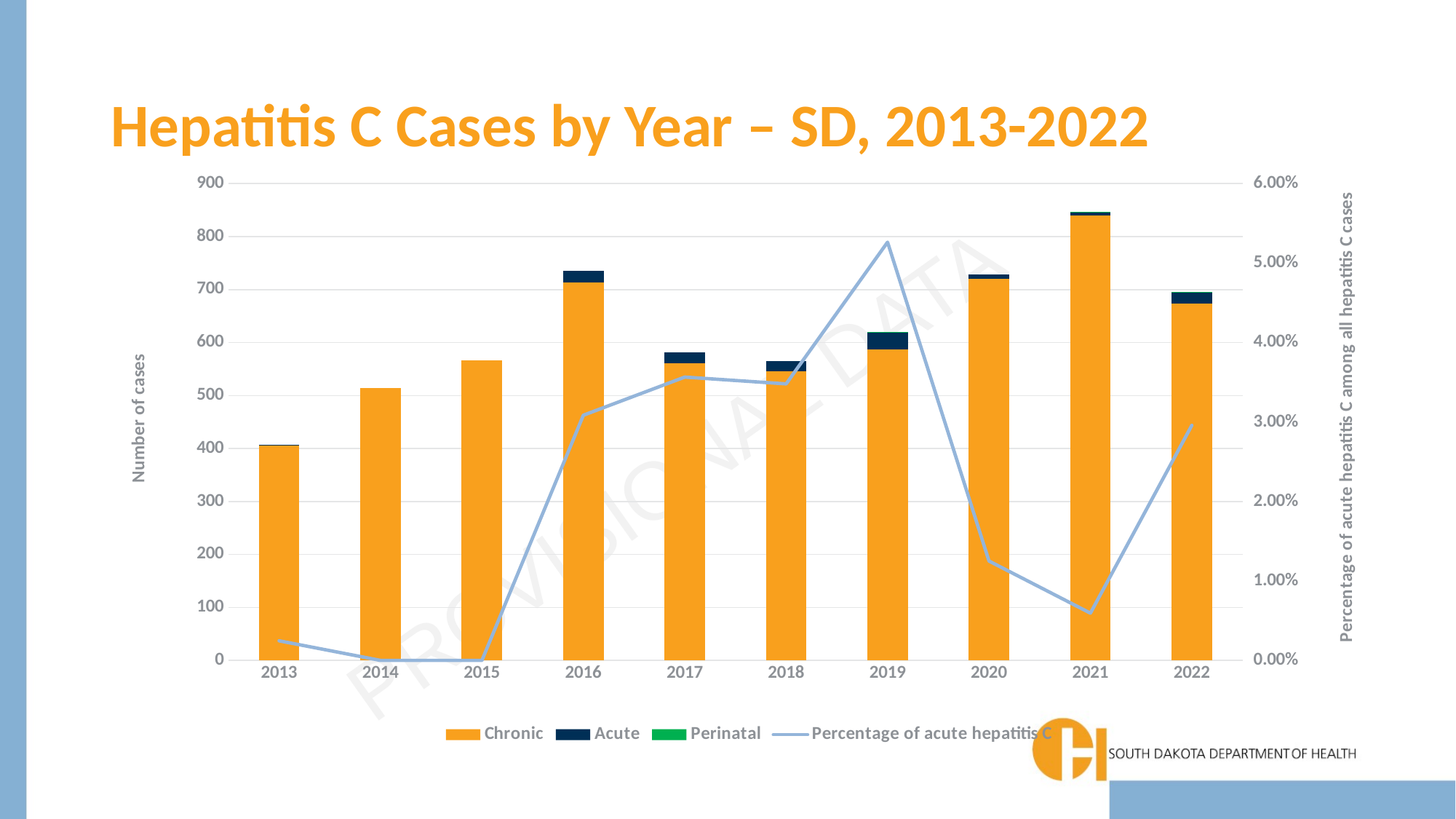
Which year has the shortest total bar for hepatitis C cases? 2013 Which year has the tallest total bar for hepatitis C cases? 2021 Is the total number of cases in 2013 greater or less than 500? less Is the total number of cases in 2021 greater or less than 800? greater In which year does the percentage of acute hepatitis C line reach its highest point? 2019 Which year has more total hepatitis C cases, 2016 or 2017? 2016 What kind of chart is shown on the slide? A combined bar and line chart (stacked bars with a line) Does the percentage of acute hepatitis C line rise or fall from 2019 to 2021? fall How many series does the legend list? 4 How many years are shown on the x axis of the chart? 10 Is the percentage of acute hepatitis C in 2021 greater or less than 1.00%? less What is the title of the chart on the slide? Hepatitis C Cases by Year – SD, 2013-2022